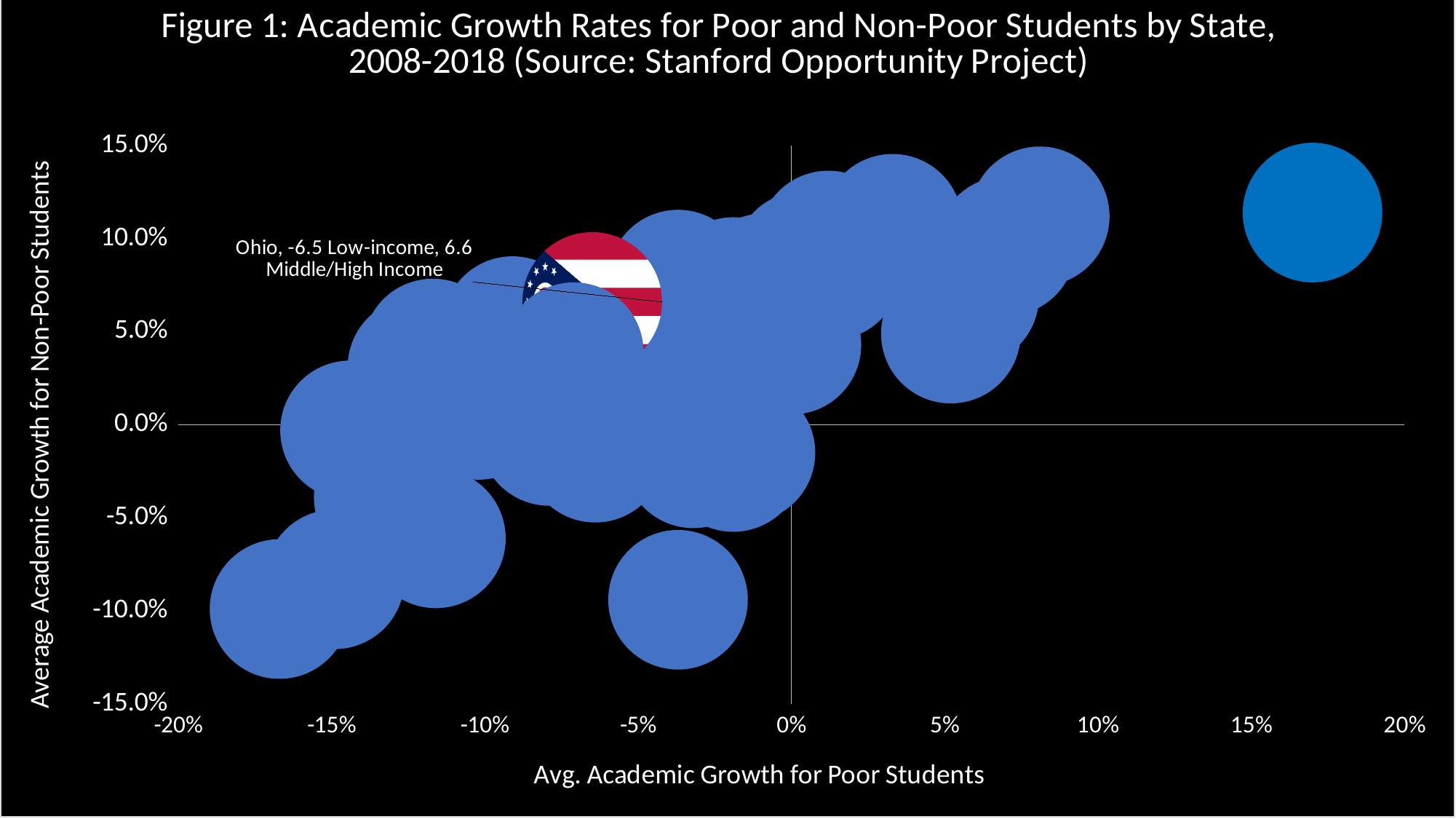
Is the horizontal (poor students) value of the rightmost bubble greater or less than 15%? greater Is the vertical (non-poor students) value of the rightmost bubble greater or less than 10.0%? greater Do the non-poor student growth values generally rise or fall as the poor student growth values increase along the x axis? rise What is the average academic growth for low-income (poor) students in Ohio? -6.5 What is the difference between Ohio's middle/high income growth value (6.6) and its low-income growth value (-6.5)? 13.1 Which is larger for Ohio: the growth value for low-income students or for middle/high income students? Middle/High Income What kind of chart is shown on the slide? bubble chart Is Ohio's value for non-poor students greater or less than 5.0%? greater What is the label of the horizontal axis? Avg. Academic Growth for Poor Students What source is cited in the chart title? Stanford Opportunity Project What is the average academic growth for middle/high income (non-poor) students in Ohio? 6.6